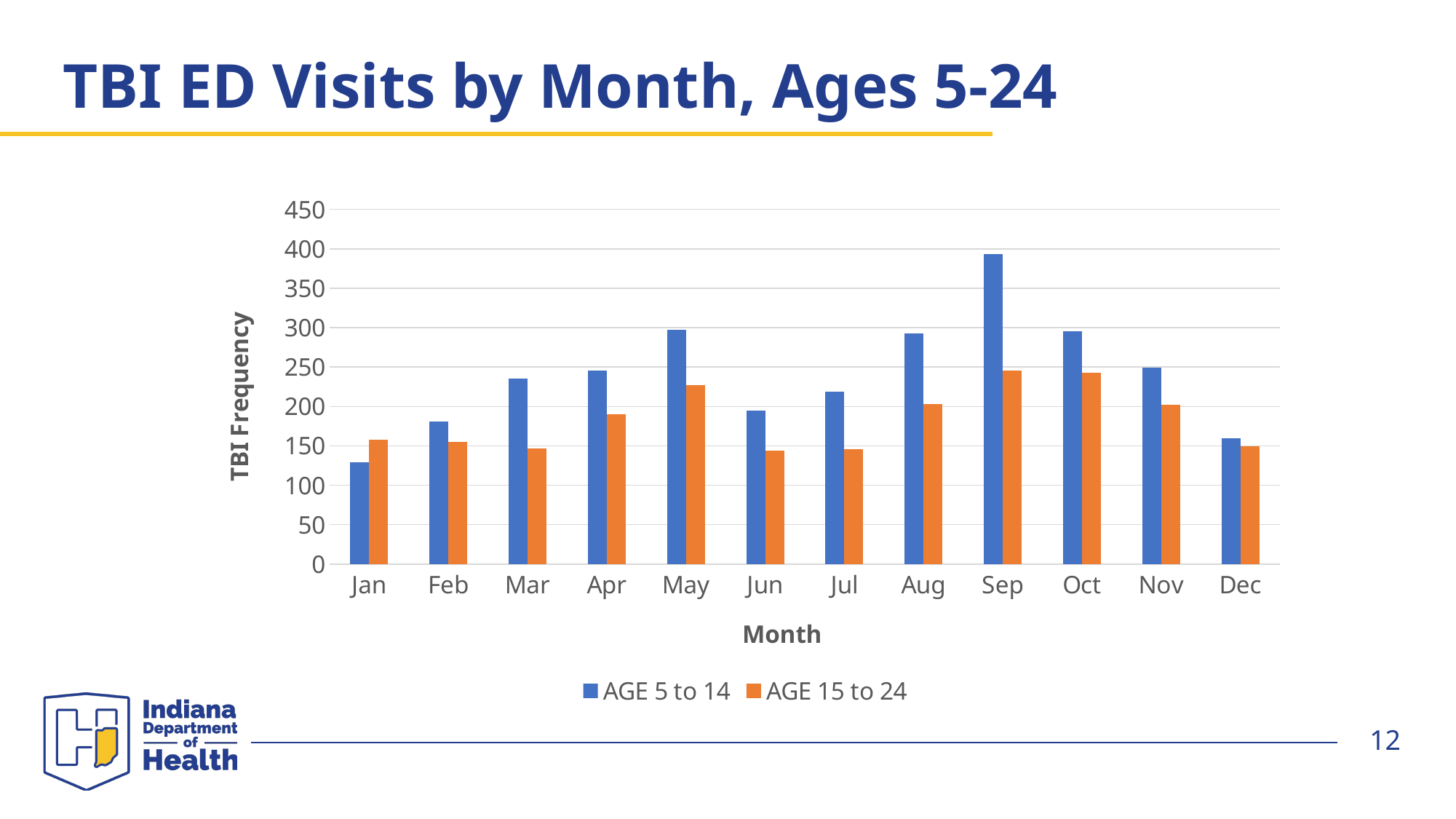
Is the value for AGE 15 to 24 in May greater or less than 200? greater How many months are shown on the x axis? 12 How many series does the legend list? 2 In which month is the value for AGE 5 to 14 highest? Sep Is the value for AGE 5 to 14 in Oct greater or less than 250? greater In Jan, which series has the larger value, AGE 5 to 14 or AGE 15 to 24? AGE 15 to 24 Do the values for AGE 5 to 14 rise or fall from Jan to May? rise Is the value for AGE 5 to 14 in Jan greater or less than 150? less What is the title of the y axis? TBI Frequency What kind of chart is shown on the slide? Bar chart In which month is the value for AGE 5 to 14 lowest? Jan